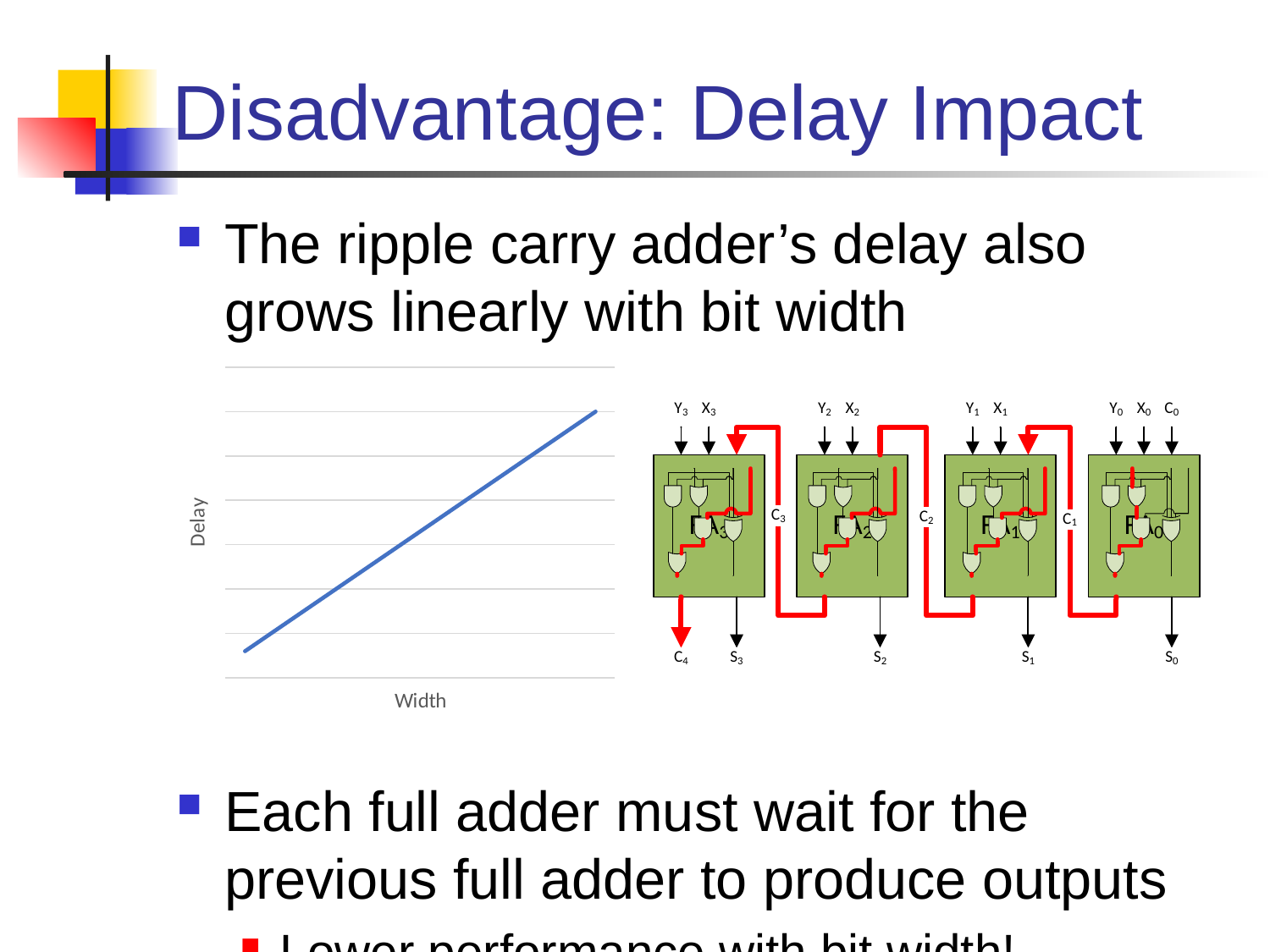
How many lines are plotted on the chart? 1 What kind of chart is shown on the slide? line chart What is the label on the vertical axis of the chart? Delay What is the label on the horizontal axis of the chart? Width Does the plotted line rise or fall as Width increases along the x axis? rises